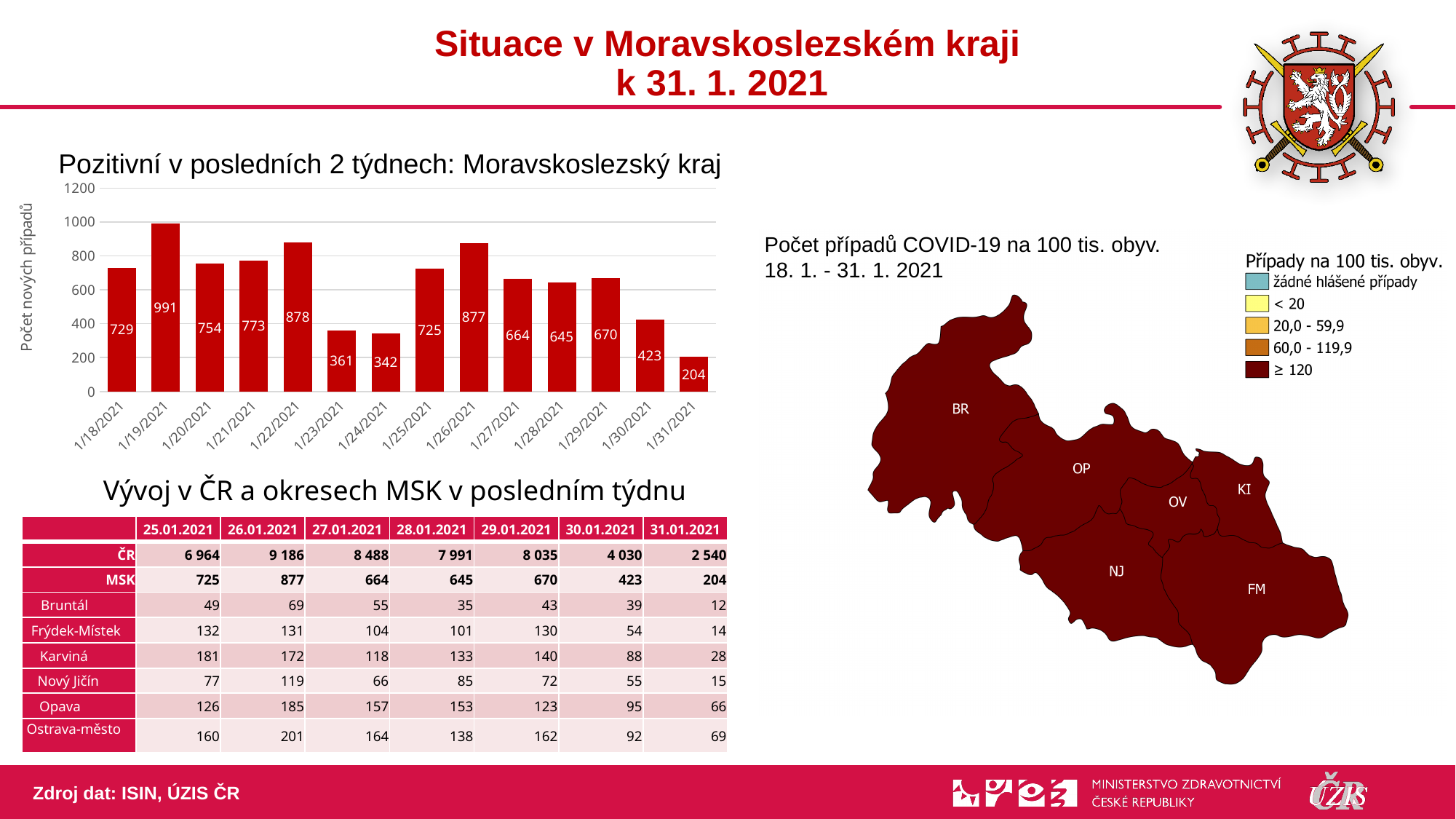
Do the values in the bar chart rise or fall from 1/29/2021 to 1/31/2021? fall What kind of chart is used to show the positive cases in the last 2 weeks? bar chart What is the value for 1/24/2021 in the bar chart? 342 Which date has the highest value in the bar chart? 1/19/2021 How many dates are shown on the x axis of the bar chart? 14 What is the value for 1/31/2021 in the bar chart? 204 What is the value for 1/19/2021 in the bar chart? 991 Which date has the lowest value in the bar chart? 1/31/2021 Is the value for 1/30/2021 in the bar chart greater or less than 400? greater Which is larger in the bar chart, the value for 1/18/2021 or the value for 1/25/2021? 1/18/2021 What is the difference between the values for 1/22/2021 and 1/23/2021 in the bar chart? 517 What is the title of the bar chart? Pozitivní v posledních 2 týdnech: Moravskoslezský kraj